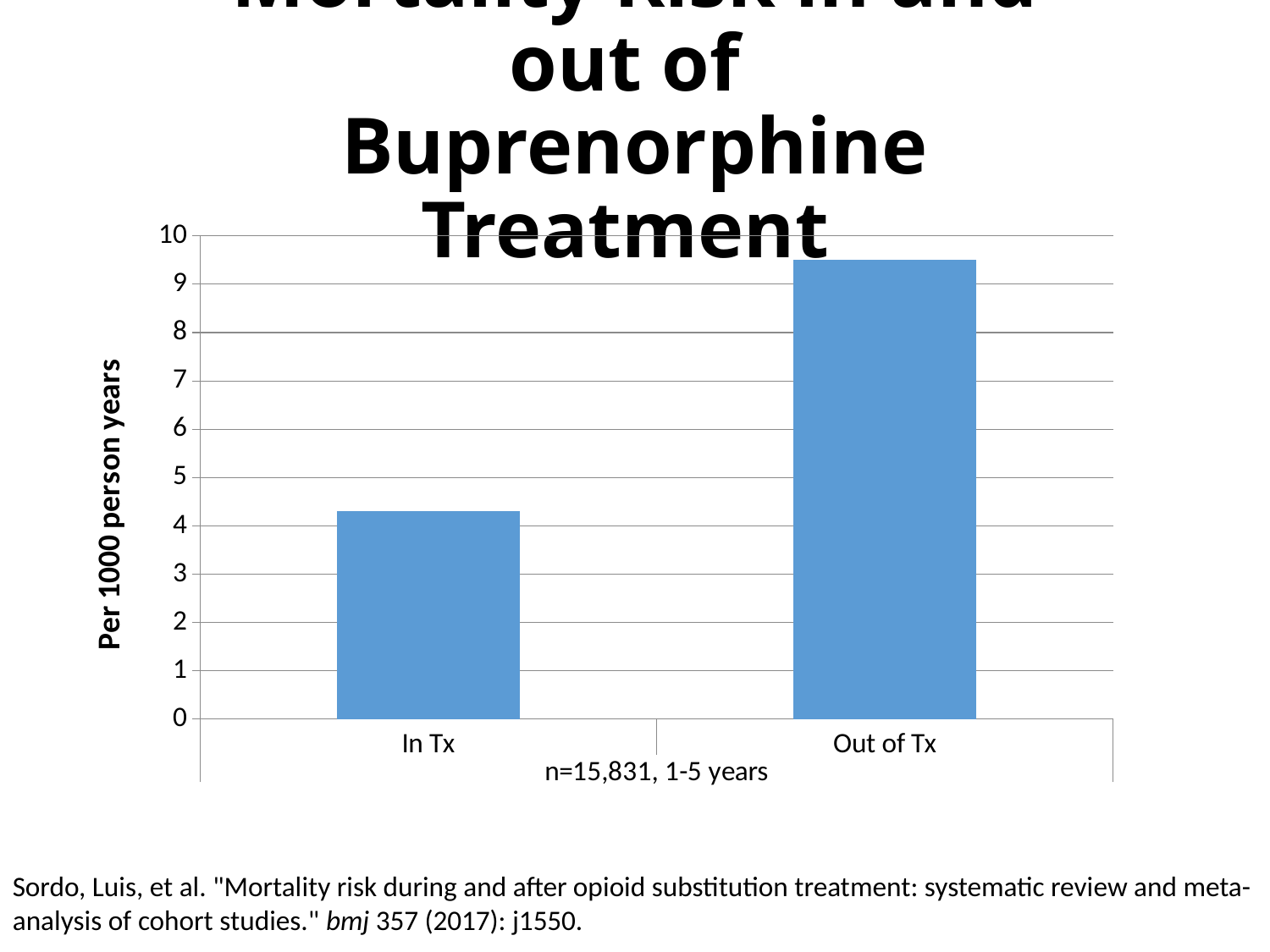
Is the value for In Tx greater or less than 3? greater Is the value for In Tx greater or less than 5? less What kind of chart is shown on the slide? bar chart Is the value for Out of Tx greater or less than 9? greater How many categories are plotted on the chart? 2 Which category has the highest value on the chart? Out of Tx Which category has the higher mortality risk, In Tx or Out of Tx? Out of Tx Which category has the lowest value on the chart? In Tx What is the label on the vertical axis of the chart? Per 1000 person years What text appears below the category labels on the horizontal axis? n=15,831, 1-5 years